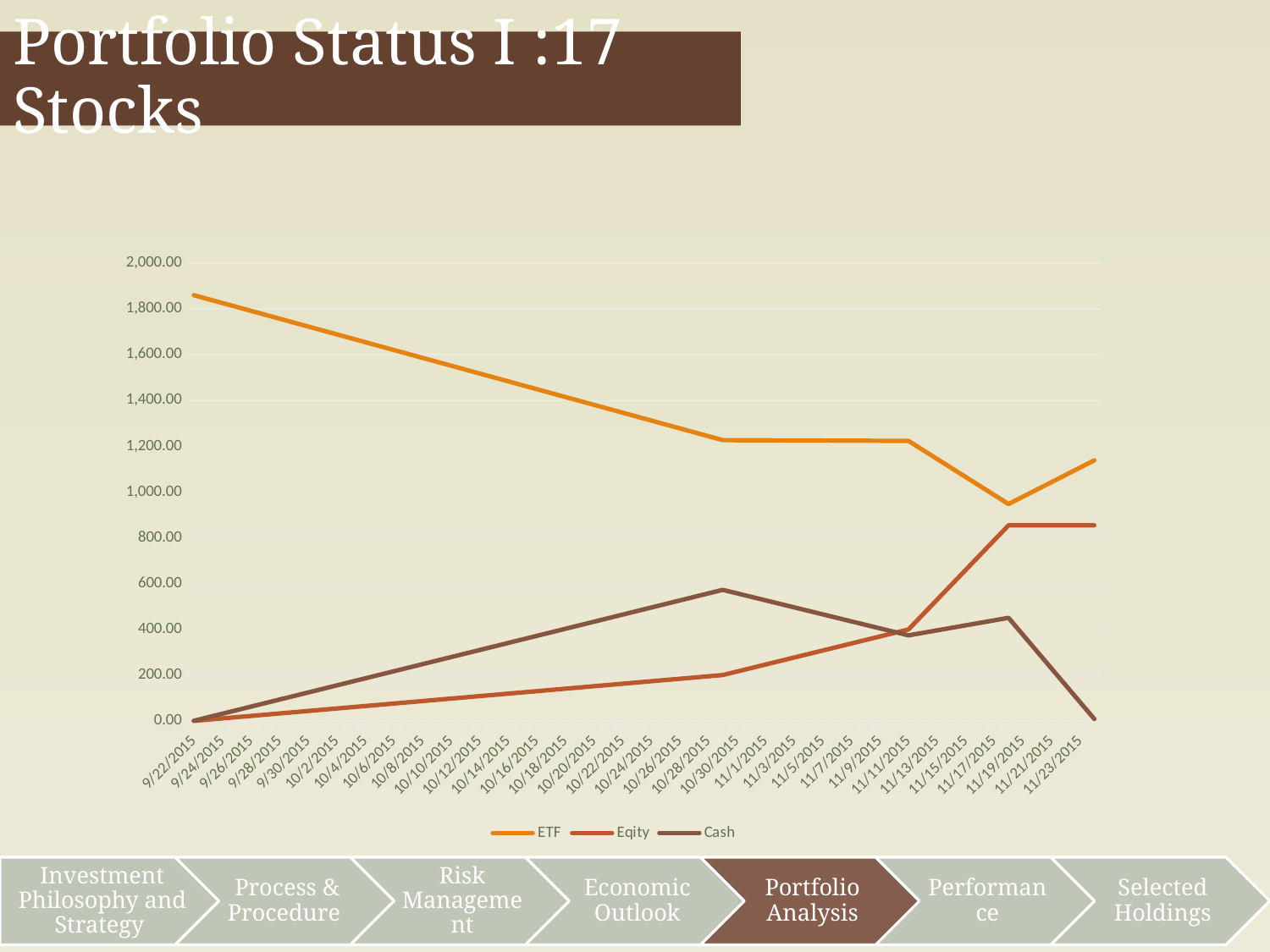
Does the ETF line rise or fall between 9/22/2015 and 10/30/2015? fall Is the Cash value on 10/30/2015 greater or less than 400.00? greater Is the ETF value on 11/19/2015 greater or less than 1,000.00? less What is the Eqity value on 9/22/2015? 0.00 Is the ETF value on 9/22/2015 greater or less than 1,800.00? greater On 11/23/2015, which series has the larger value, ETF or Eqity? ETF What are the series names listed in the chart's legend? ETF, Eqity, Cash On 10/30/2015, which series has the larger value, Cash or Eqity? Cash Which series has the highest value on 9/22/2015? ETF What kind of chart is shown on the slide? line chart How many series does the chart's legend list? 3